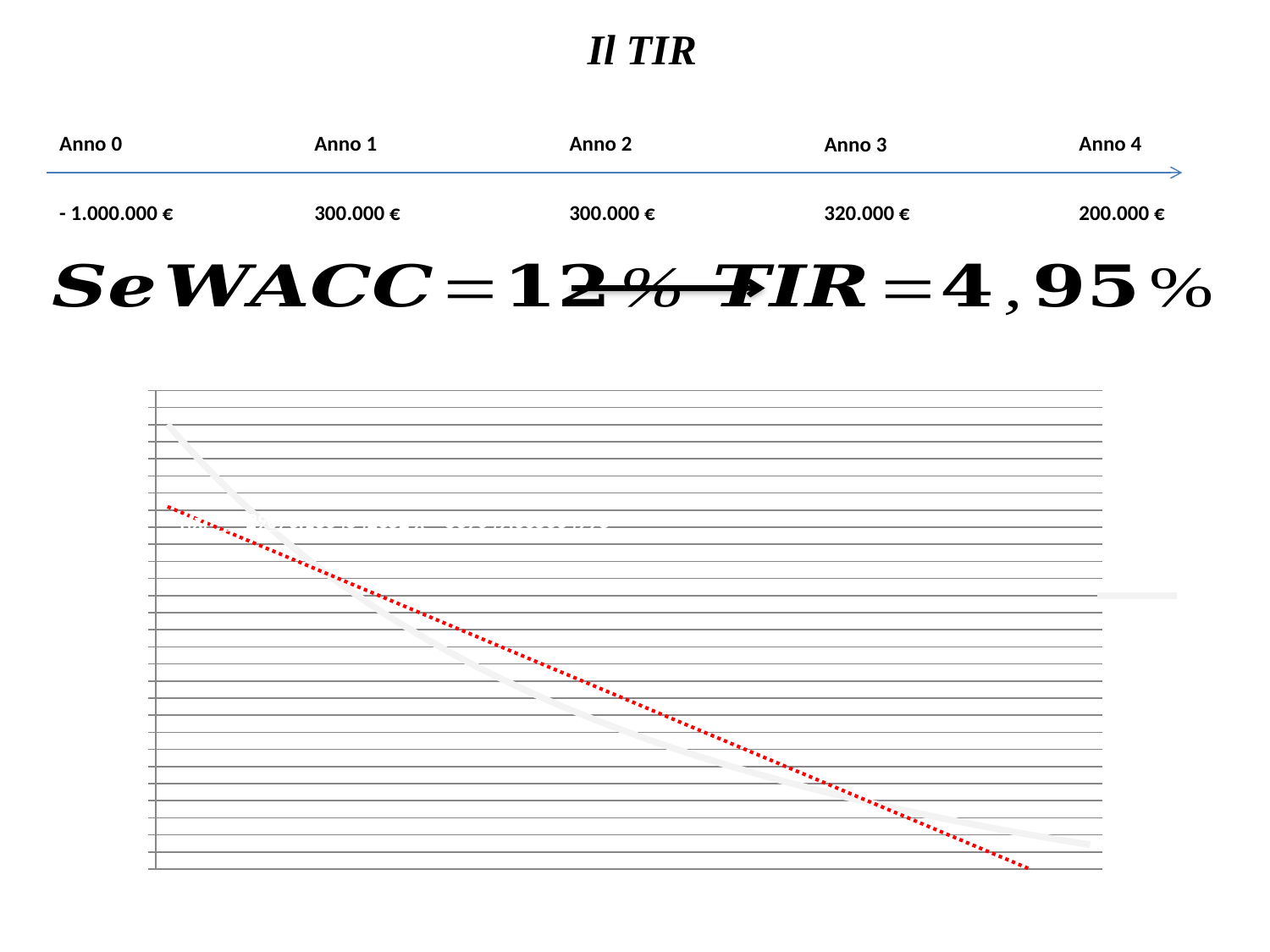
How many lines are plotted on the chart? 2 Do the plotted lines rise or fall from left to right along the x axis? fall What kind of chart is shown on the slide? line chart What colour is the dotted line on the chart? red